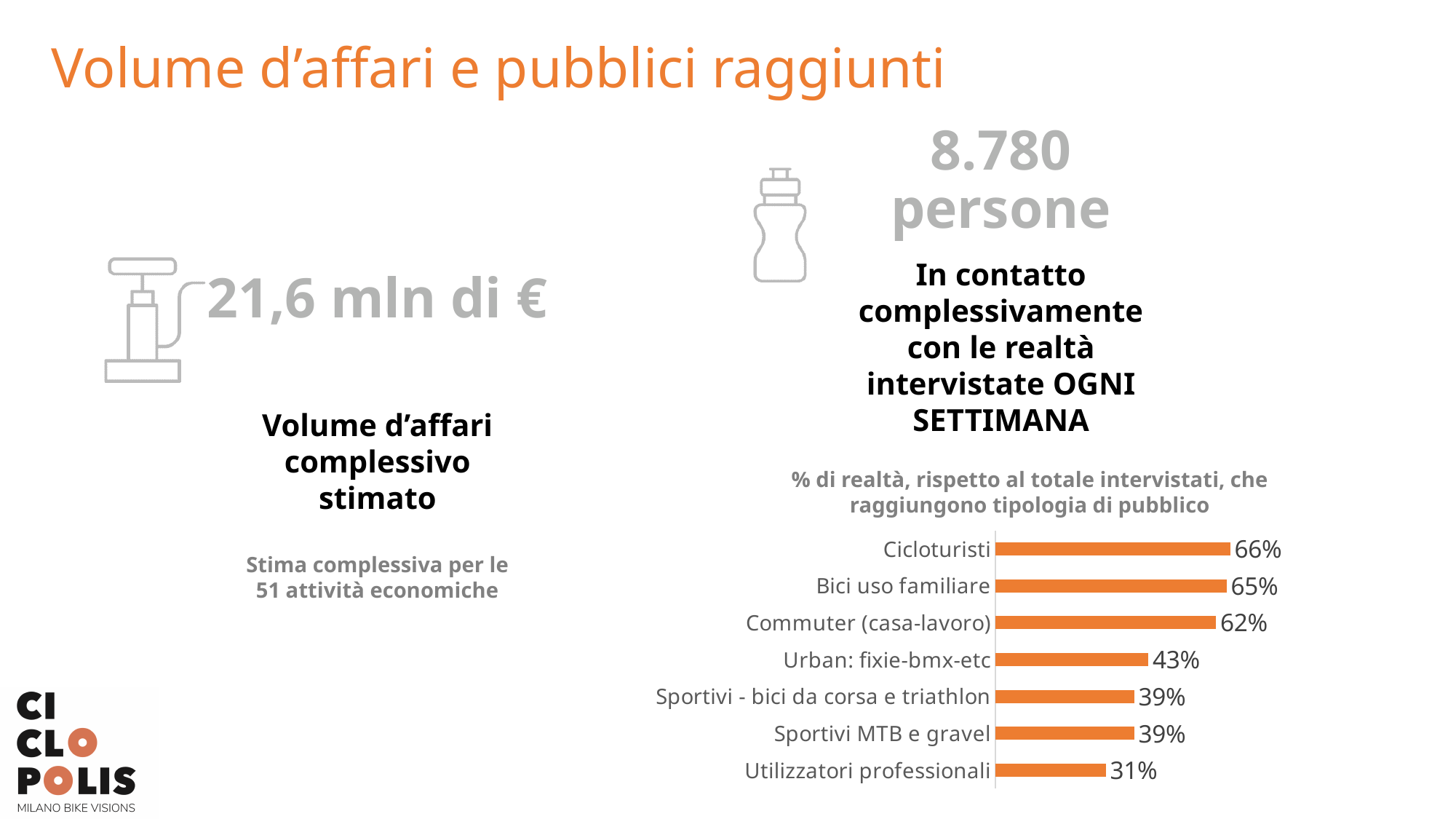
What is the value for Cicloturisti? 66% Which category has the lowest value? Utilizzatori professionali What is the value for Commuter (casa-lavoro)? 62% What is the difference between the values for Commuter (casa-lavoro) and Urban: fixie-bmx-etc? 19% What is the difference between the values for Cicloturisti and Utilizzatori professionali? 35% What is the title of the chart? % di realtà, rispetto al totale intervistati, che raggiungono tipologia di pubblico Which is larger, the value for Bici uso familiare or the value for Sportivi MTB e gravel? Bici uso familiare What is the value for Urban: fixie-bmx-etc? 43% What kind of chart is shown on the slide? Bar chart What is the value for Utilizzatori professionali? 31% How many categories are shown in the chart? 7 Which category has the highest value? Cicloturisti